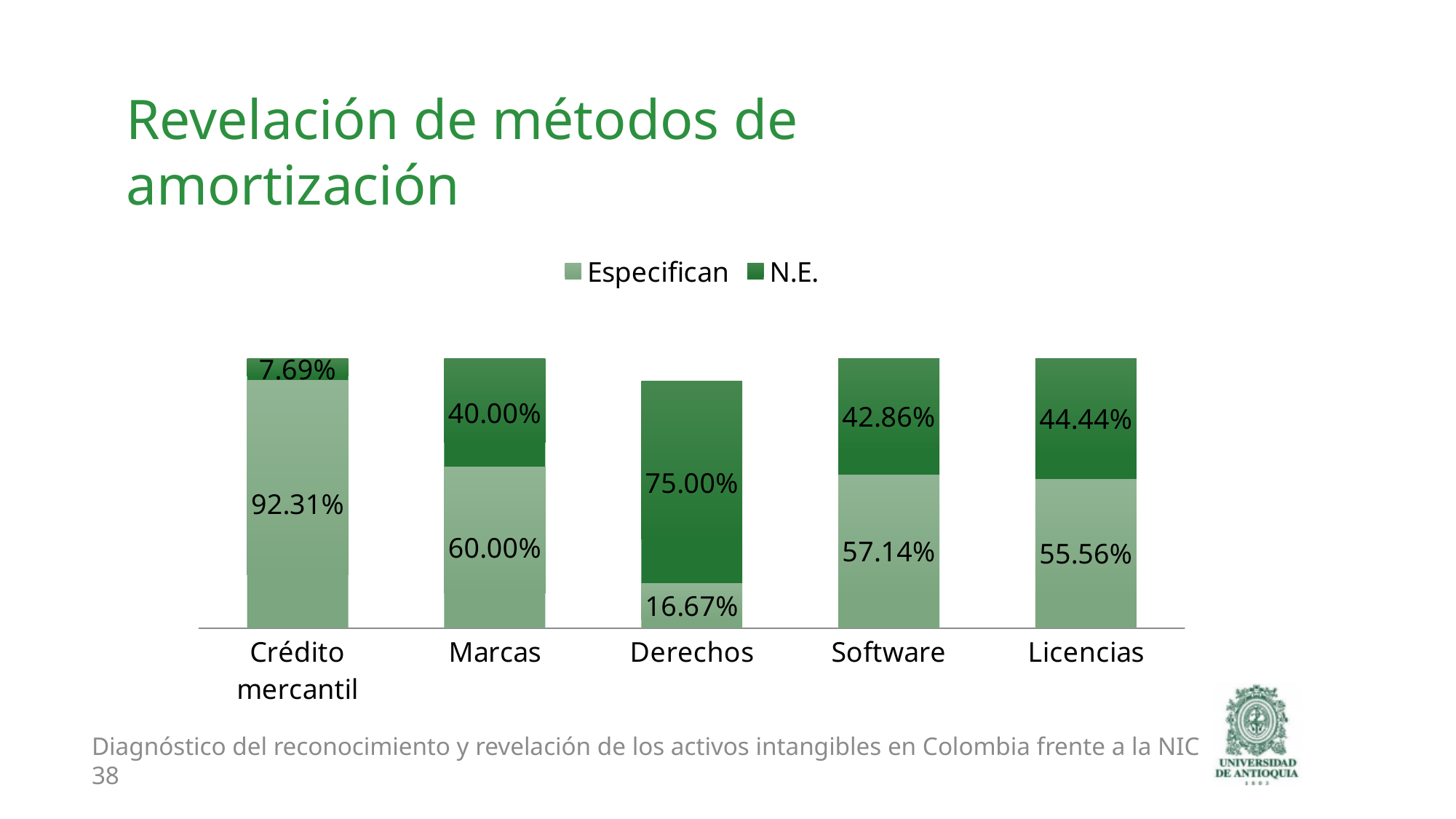
What is the N.E. value for Licencias? 44.44% Which category has the lowest N.E. value? Crédito mercantil What is the Especifican value for Software? 57.14% What is the Especifican value for Crédito mercantil? 92.31% Which is larger for Software: the Especifican value or the N.E. value? Especifican What is the difference between the Especifican and N.E. values for Marcas? 20.00% How many categories are shown on the x axis? 5 Which category has the highest Especifican value? Crédito mercantil What is the N.E. value for Derechos? 75.00% Which category has the lowest Especifican value? Derechos What kind of chart is shown on the slide? Stacked bar chart How many series does the legend list? 2